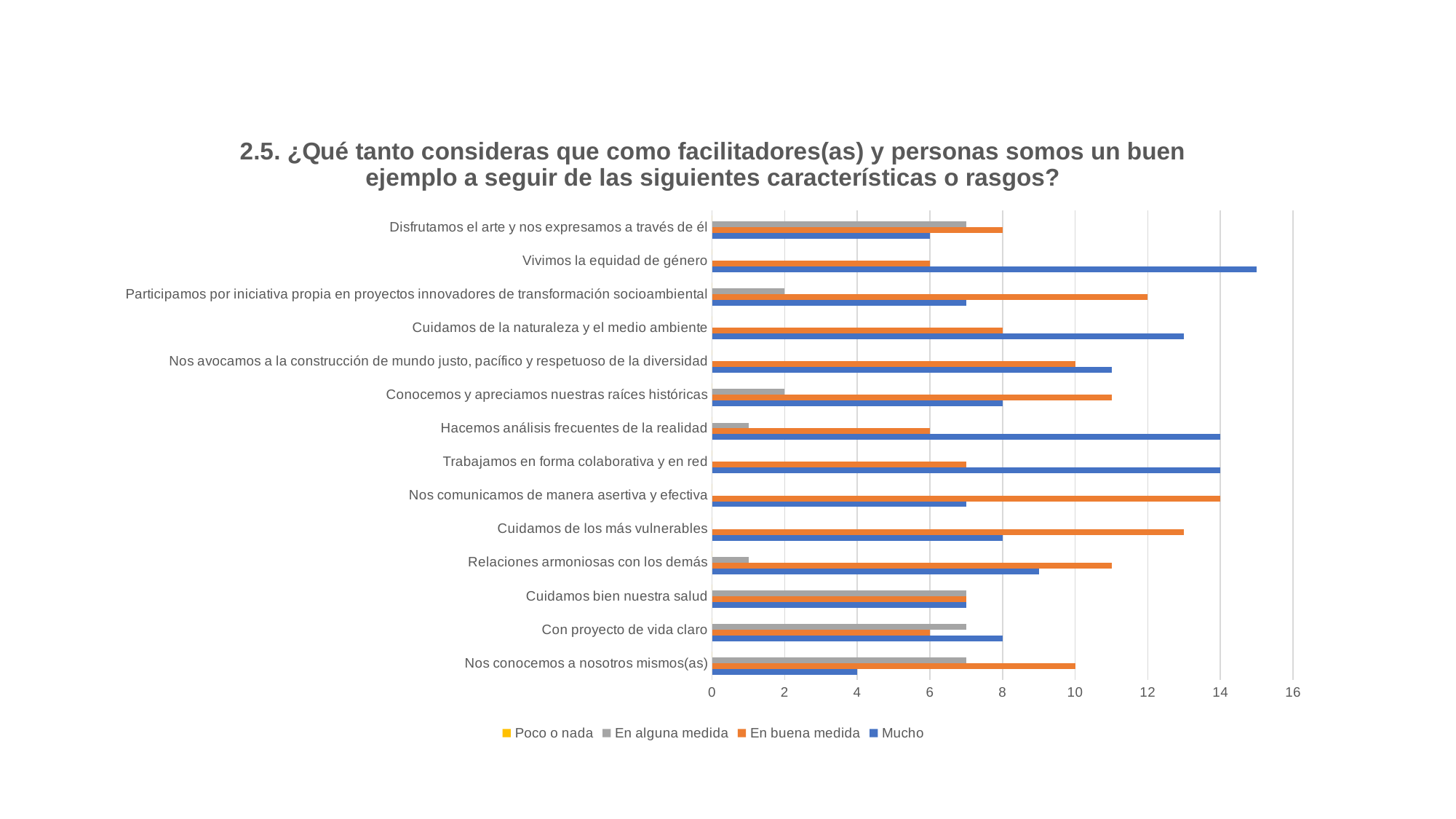
What is the value of the 'Mucho' series for 'Nos conocemos a nosotros mismos(as)'? 4 What kind of chart is shown on the slide? bar chart Which category has the highest value in the 'Mucho' series? Vivimos la equidad de género How many series does the legend list? 4 Which category has the lowest value in the 'Mucho' series? Nos conocemos a nosotros mismos(as) What is the value of the 'En buena medida' series for 'Participamos por iniciativa propia en proyectos innovadores de transformación socioambiental'? 12 How many categories (characteristics) are plotted on the chart? 14 What is the value of the 'En buena medida' series for 'Nos comunicamos de manera asertiva y efectiva'? 14 Is the 'Mucho' value for 'Vivimos la equidad de género' greater or less than 14? greater For 'Nos comunicamos de manera asertiva y efectiva', which series has the larger value: 'En buena medida' or 'Mucho'? En buena medida For 'Hacemos análisis frecuentes de la realidad', what is the difference between the 'Mucho' value and the 'En buena medida' value? 8 What is the value of the 'Mucho' series for 'Hacemos análisis frecuentes de la realidad'? 14